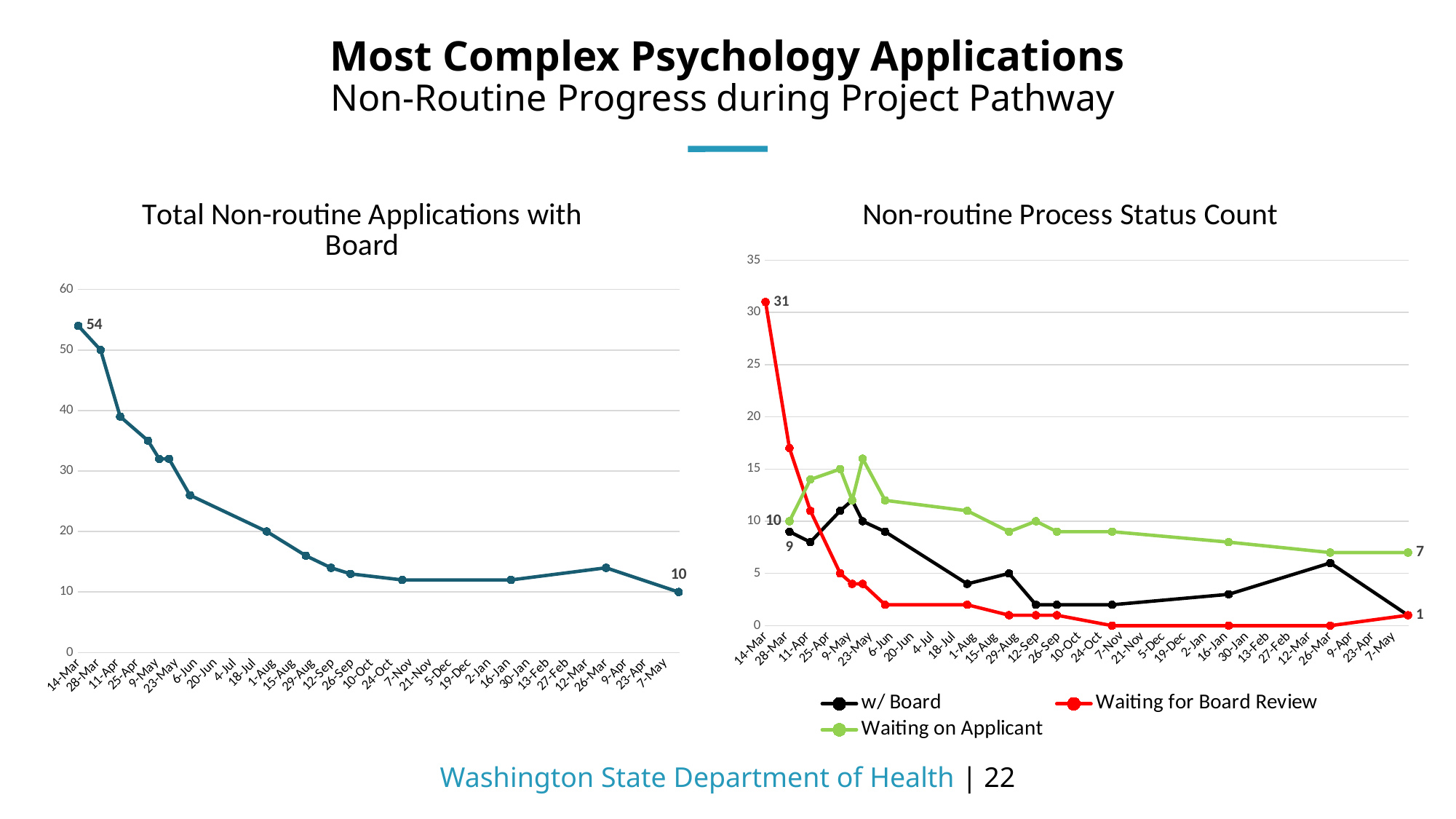
What kind of chart is the 'Non-routine Process Status Count' chart? line chart On the 'Total Non-routine Applications with Board' chart, what is the value at 7-May? 10 On the 'Total Non-routine Applications with Board' chart, is the value at 6-Jun greater or less than 20? greater On the 'Non-routine Process Status Count' chart, how many series does the legend list? 3 On the 'Non-routine Process Status Count' chart, what is the value for Waiting on Applicant at 7-May? 7 On the 'Non-routine Process Status Count' chart, is the value for Waiting for Board Review at 28-Mar greater or less than 15? greater On the 'Total Non-routine Applications with Board' chart, what is the value at 14-Mar? 54 On the 'Non-routine Process Status Count' chart, what is the value for Waiting for Board Review at 14-Mar? 31 On the 'Total Non-routine Applications with Board' chart, do the values generally rise or fall from 14-Mar to 7-May? fall On the 'Total Non-routine Applications with Board' chart, what is the difference between the first value (14-Mar) and the last value (7-May)? 44 On the 'Non-routine Process Status Count' chart, which series has the highest value at 14-Mar? Waiting for Board Review